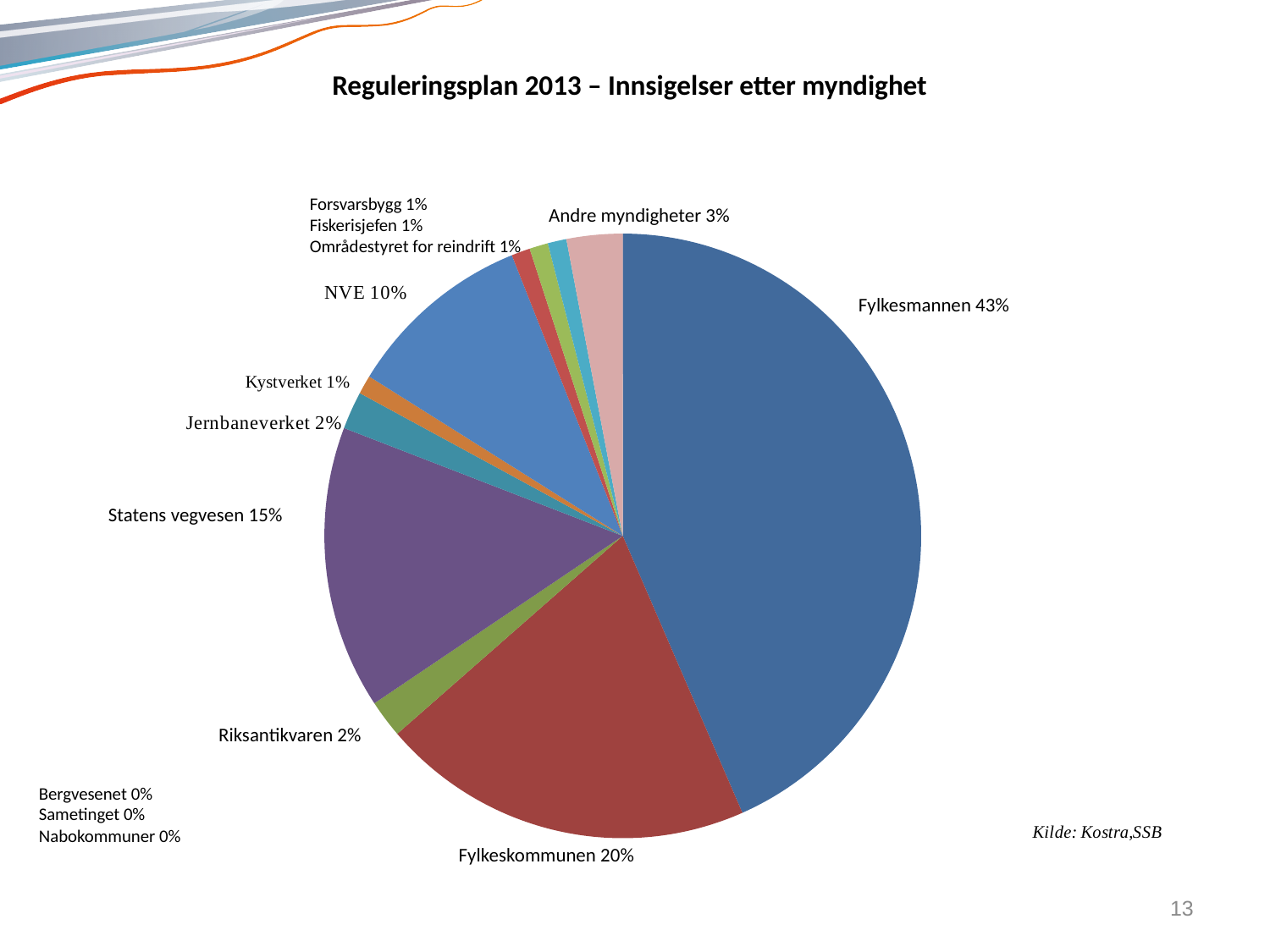
Which is larger, the share for Statens vegvesen or the share for NVE? Statens vegvesen What is the value shown for Andre myndigheter? 3% What is the title of the chart? Reguleringsplan 2013 – Innsigelser etter myndighet What is the difference in percentage points between Fylkesmannen and Fylkeskommunen? 23 What is the difference in percentage points between Statens vegvesen and Riksantikvaren? 13 What is the value shown for Statens vegvesen? 15% Which category has the largest slice of the pie? Fylkesmannen How many labelled categories does the pie chart show? 14 What is the value shown for NVE? 10% What share of the pie does Fylkesmannen account for? 43% What is the value shown for Fylkeskommunen? 20% What kind of chart is shown on the slide? pie chart